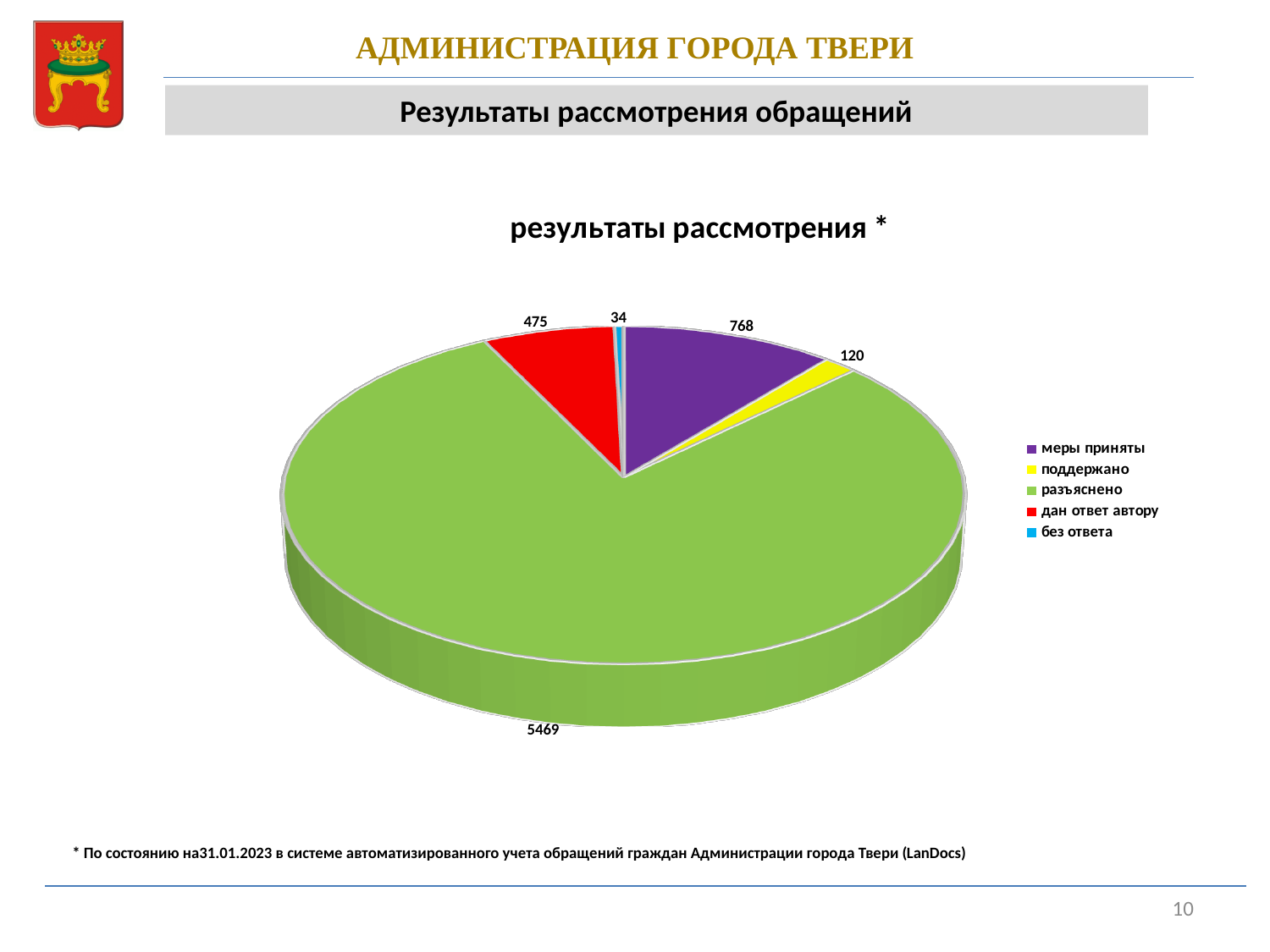
Which category has the largest slice in the pie chart? разъяснено What is the value for разъяснено in the pie chart? 5469 What is the difference between the values for меры приняты and дан ответ автору? 293 Which category has the smallest slice in the pie chart? без ответа What is the value for дан ответ автору in the pie chart? 475 What is the value for без ответа in the pie chart? 34 How many categories does the pie chart show? 5 What colour is the разъяснено slice in the pie chart? green What type of chart is shown on the slide? pie chart What is the value for меры приняты in the pie chart? 768 Which is larger: the value for дан ответ автору or the value for поддержано? дан ответ автору What is the value for поддержано in the pie chart? 120